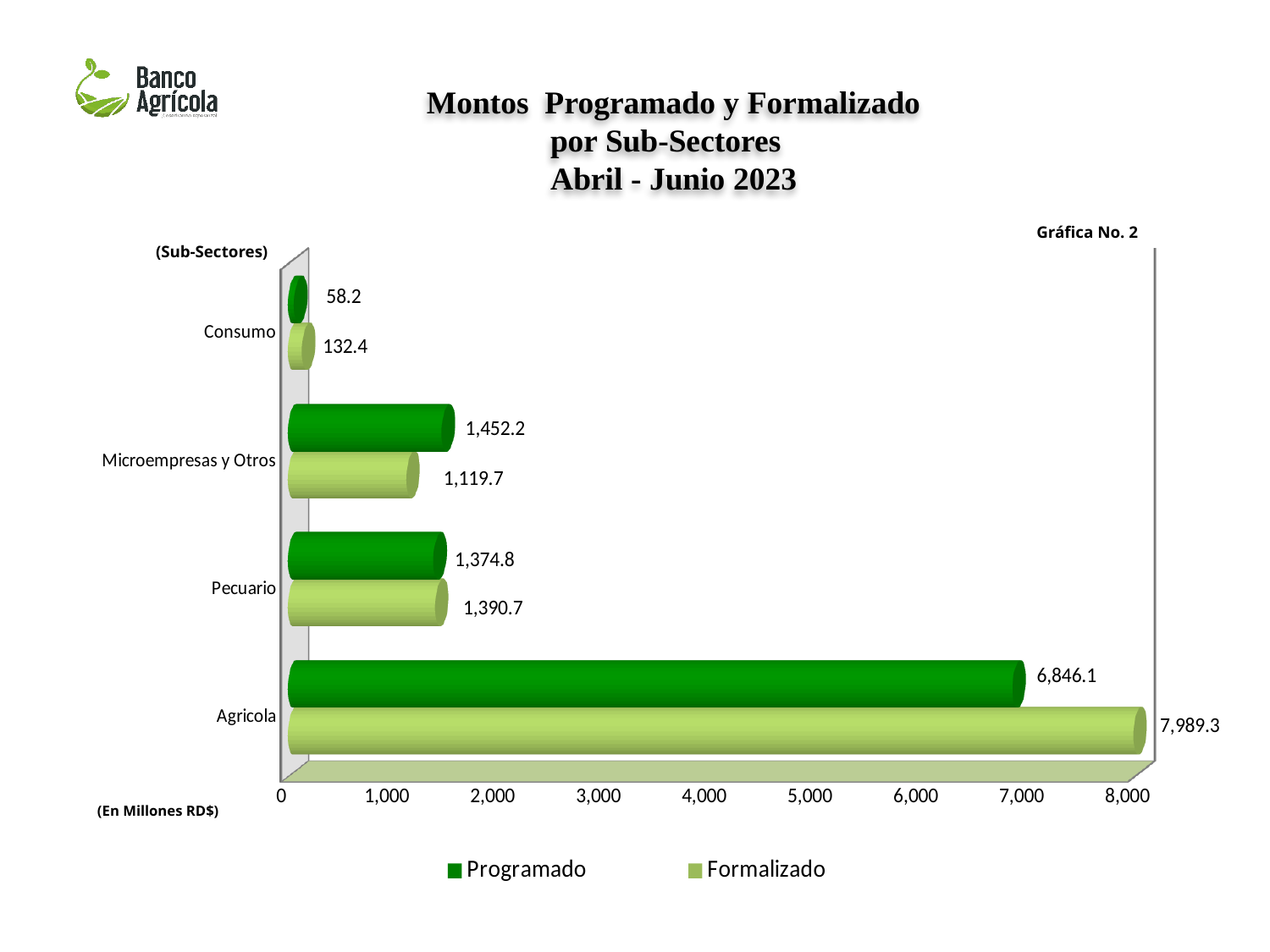
What is the Programado value for Agricola? 6,846.1 Which sub-sector has the highest Formalizado value? Agricola Is the Formalizado value for Agricola greater or less than 7,000? greater What is the Formalizado value for Microempresas y Otros? 1,119.7 What is the difference between the Programado and Formalizado values for Microempresas y Otros? 332.5 Which sub-sector has the lowest Programado value? Consumo How many series does the legend list? 2 How many sub-sectors are shown on the chart? 4 What is the Formalizado value for Consumo? 132.4 What kind of chart is shown on the slide? Bar chart For Consumo, which is larger: the Programado value or the Formalizado value? Formalizado What is the difference between the Formalizado and Programado values for Agricola? 1,143.2